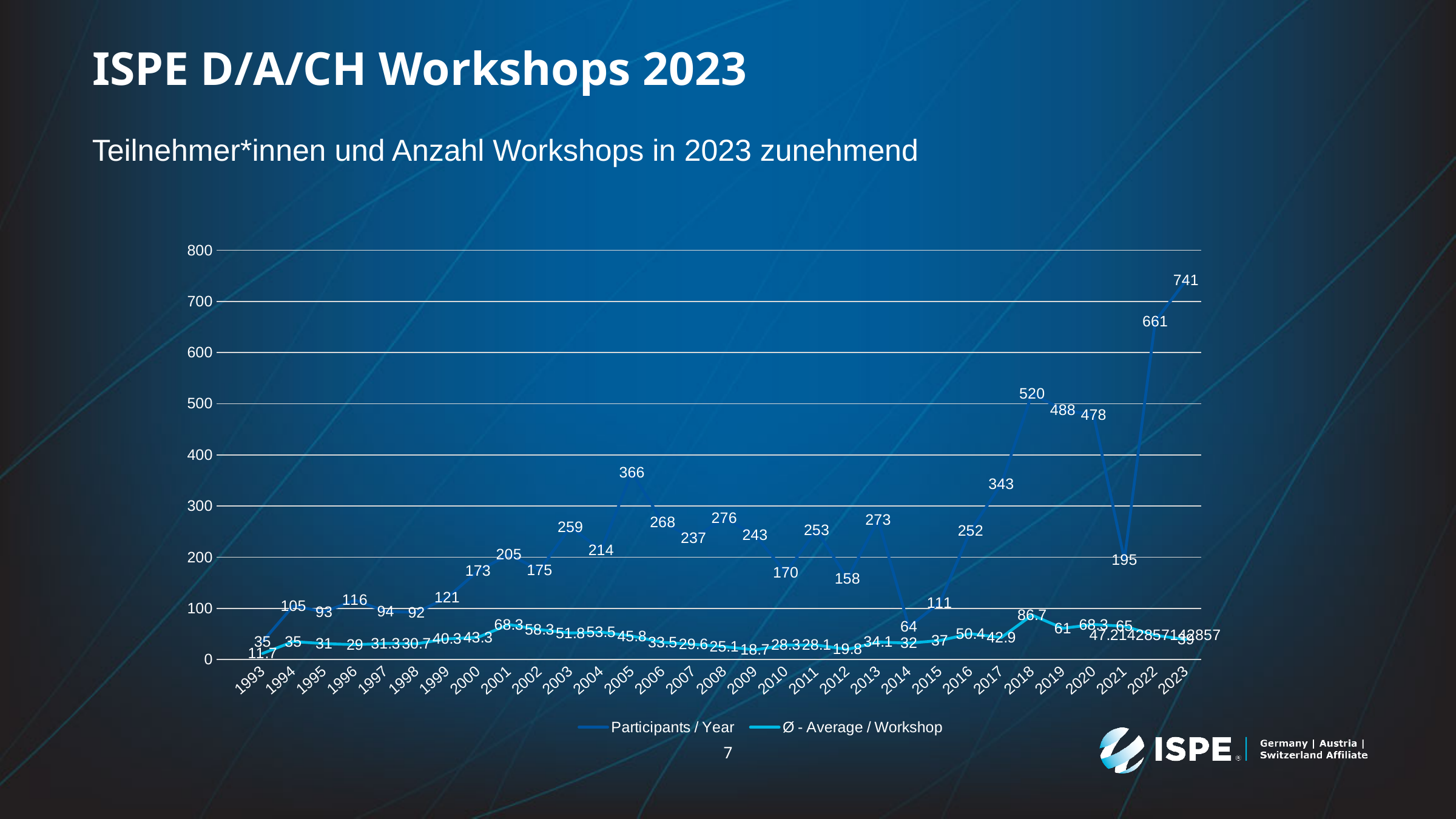
How many series does the legend list? 2 What is the difference in Participants / Year between 2023 and 2022? 80 What is the Ø - Average / Workshop value for 2001? 68.3 What is the value of Participants / Year for 2023? 741 What is the value of Participants / Year for 2018? 520 Is the Participants / Year value for 2022 greater or less than 600? greater Which year has the lowest Participants / Year value? 1993 How many years are shown on the x axis? 31 Which year has more Participants / Year, 2005 or 2017? 2005 Which year has the highest Participants / Year value? 2023 What kind of chart is shown on the slide? Line chart Which year has the highest Ø - Average / Workshop value? 2018